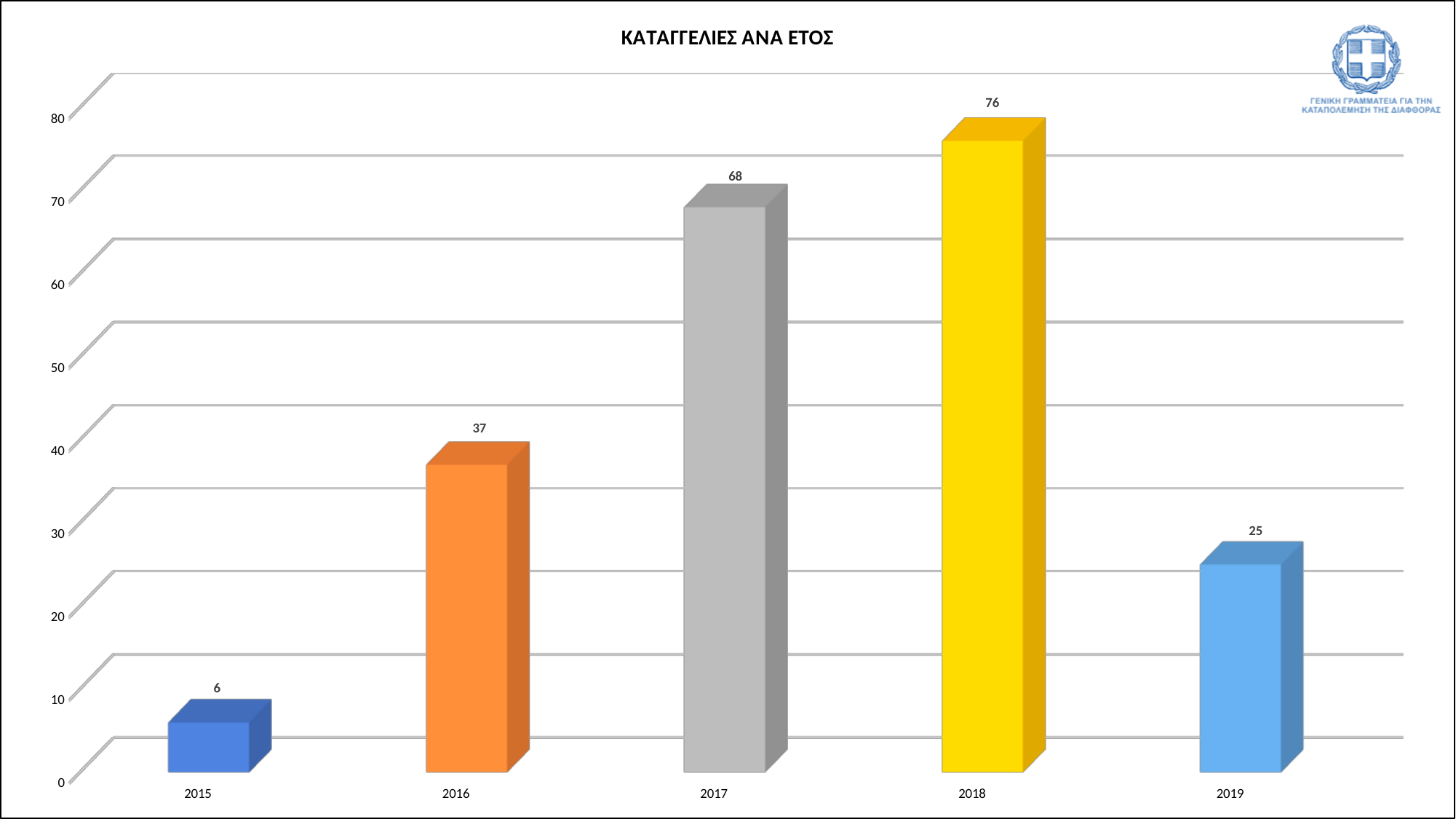
What is the value for 2019? 25 Which is larger, the value for 2016 or the value for 2019? 2016 What is the value for 2017? 68 What is the value for 2015? 6 What is the difference between the values for 2018 and 2017? 8 What is the difference between the values for 2016 and 2019? 12 What kind of chart is shown? bar chart Which year has the lowest value? 2015 How many years are shown on the x axis? 5 Which year has the highest value? 2018 What is the title of the chart? ΚΑΤΑΓΓΕΛΙΕΣ ΑΝΑ ΕΤΟΣ Is the value for 2017 greater or less than 60? greater